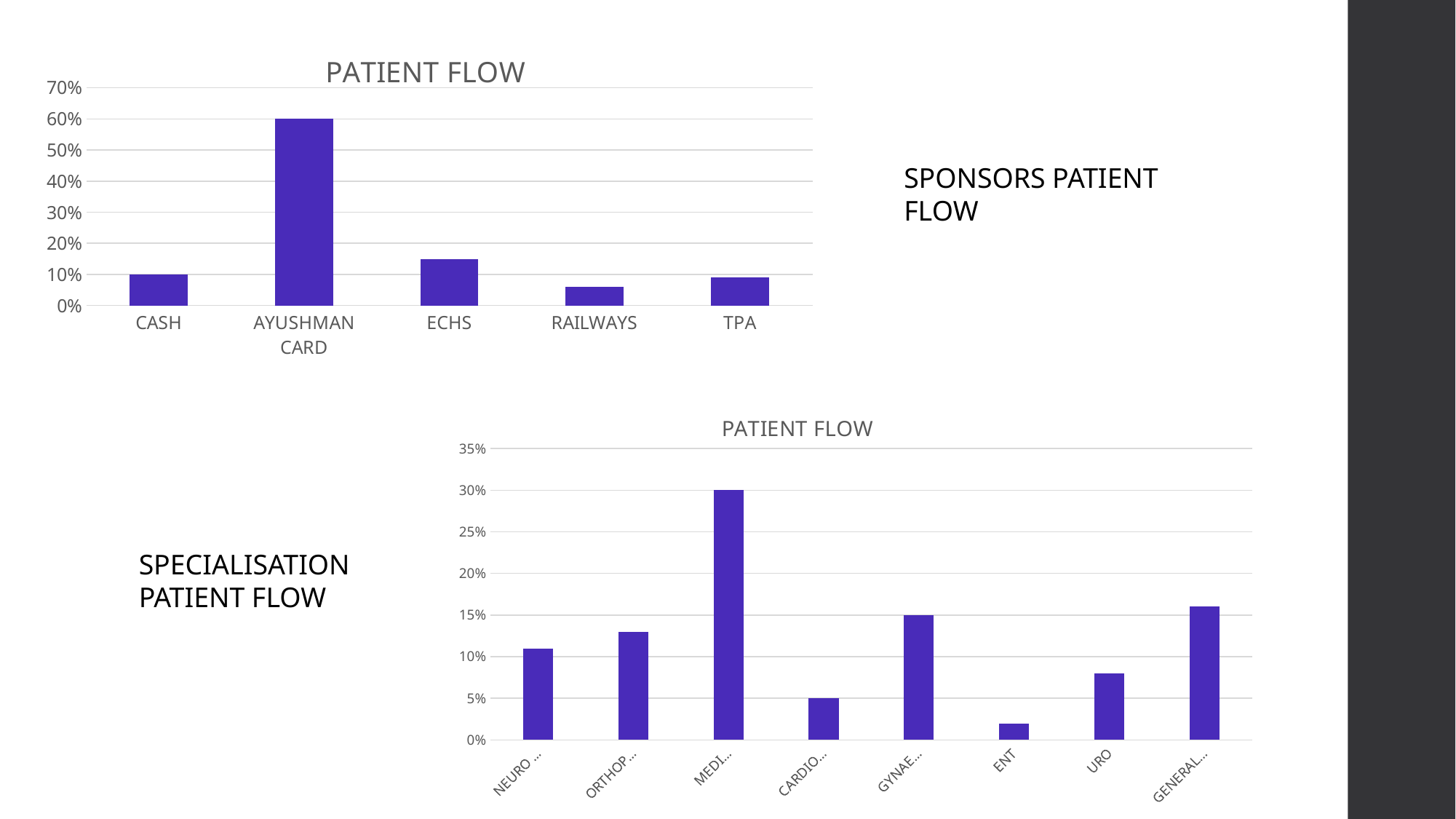
On the top chart (sponsors patient flow), what is the difference between the values for AYUSHMAN CARD and CASH? 50% On the top chart (sponsors patient flow), which category has the lowest value? RAILWAYS On the bottom chart (specialisation patient flow), is the value for URO greater or less than 10%? less On the top chart (sponsors patient flow), what is the value for AYUSHMAN CARD? 60% On the top chart (sponsors patient flow), is the value for ECHS greater or less than 20%? less On the bottom chart (specialisation patient flow), which category has the lowest value? ENT On the bottom chart (specialisation patient flow), how many categories are shown? 8 On the top chart (sponsors patient flow), how many categories are shown? 5 On the top chart (sponsors patient flow), which category has the highest value? AYUSHMAN CARD What kind of chart is the bottom chart (specialisation patient flow)? bar chart On the top chart (sponsors patient flow), what is the value for CASH? 10% On the bottom chart (specialisation patient flow), what is the value for CARDIO...? 5%